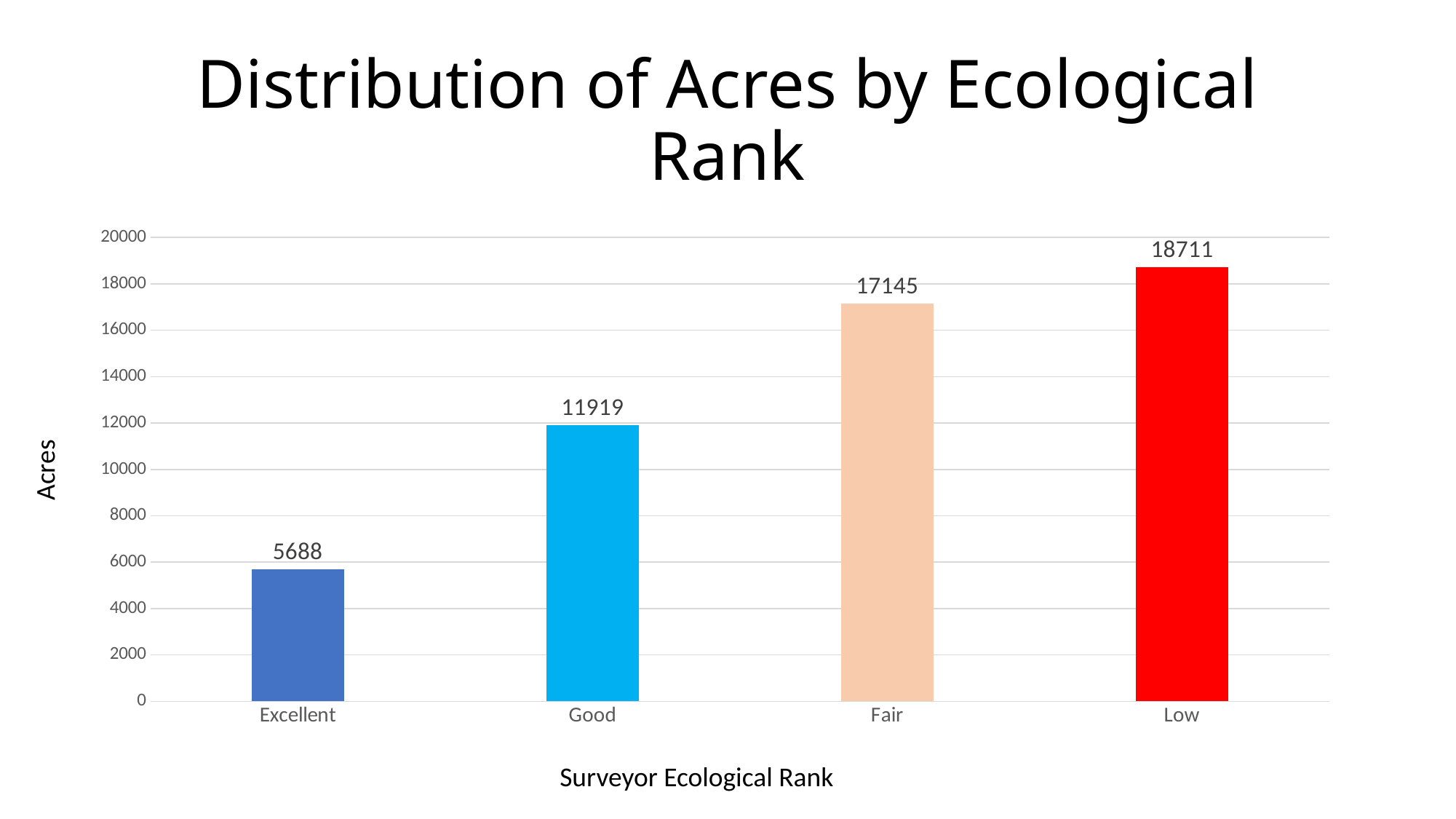
What is the number of acres for the Good ecological rank? 11919 What is the number of acres for the Excellent ecological rank? 5688 Do the acre values rise or fall moving from Excellent to Low along the x axis? Rise Which ecological rank has the lowest number of acres? Excellent What kind of chart is shown on the slide? Bar chart What is the difference in acres between the Low and Excellent ranks? 13023 What is the number of acres for the Low ecological rank? 18711 What is the number of acres for the Fair ecological rank? 17145 How many ecological rank categories are shown on the chart? 4 Which has more acres, Good or Fair? Fair Which ecological rank has the highest number of acres? Low What is the difference in acres between the Fair and Good ranks? 5226